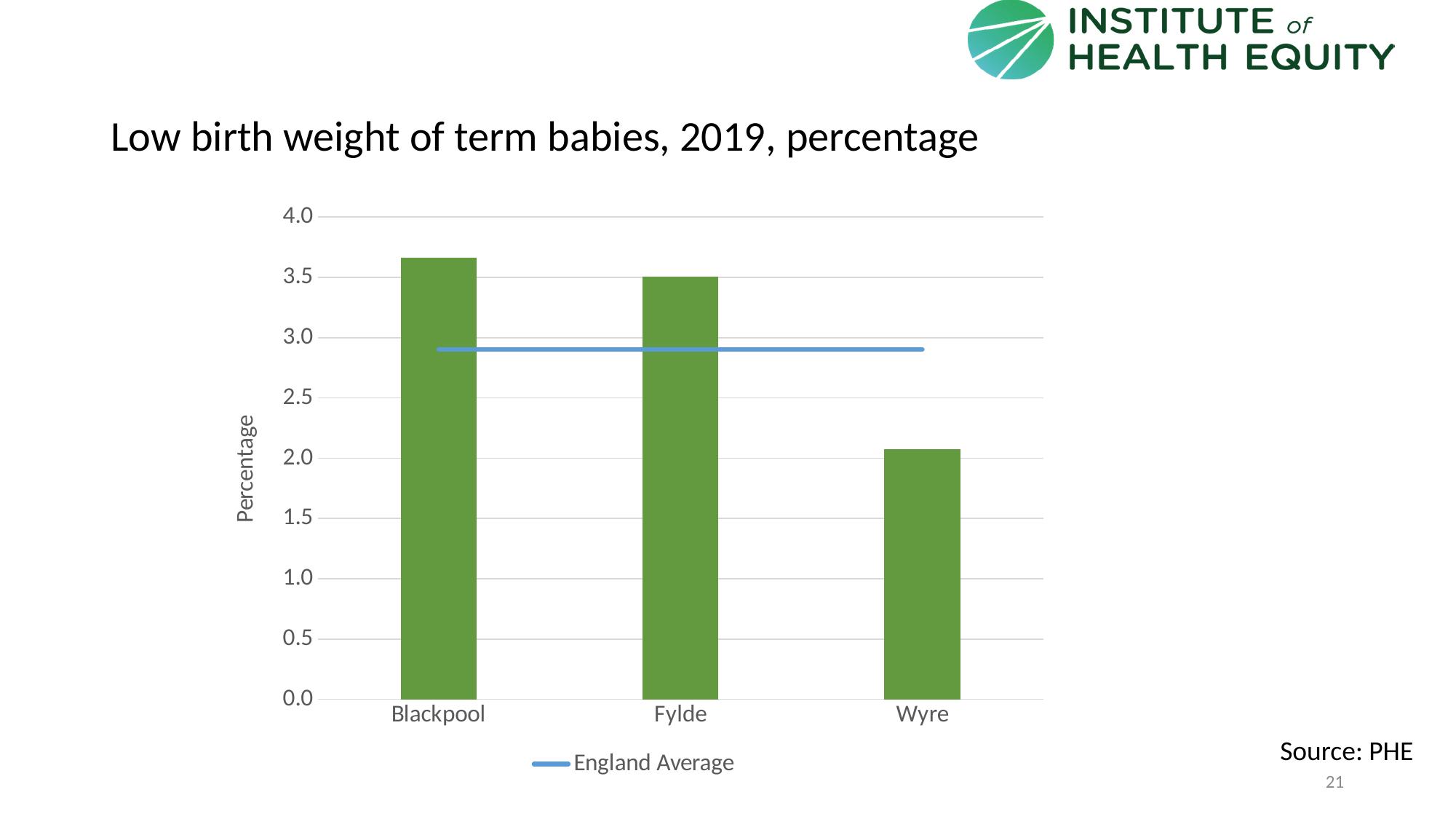
Is the value for Wyre greater or less than 2.5? less Which has the larger value, Fylde or Wyre? Fylde Is the value for Blackpool greater or less than 3.5? greater Which area has the highest low birth weight percentage? Blackpool What kind of chart is shown on the slide? bar chart Is the England Average line greater or less than 3.0? less Which has the larger value, Blackpool or Fylde? Blackpool How many entries does the chart legend list? 1 Which area has the lowest low birth weight percentage? Wyre How many local areas are shown on the x axis of the chart? 3 What is the title of the chart on the slide? Low birth weight of term babies, 2019, percentage